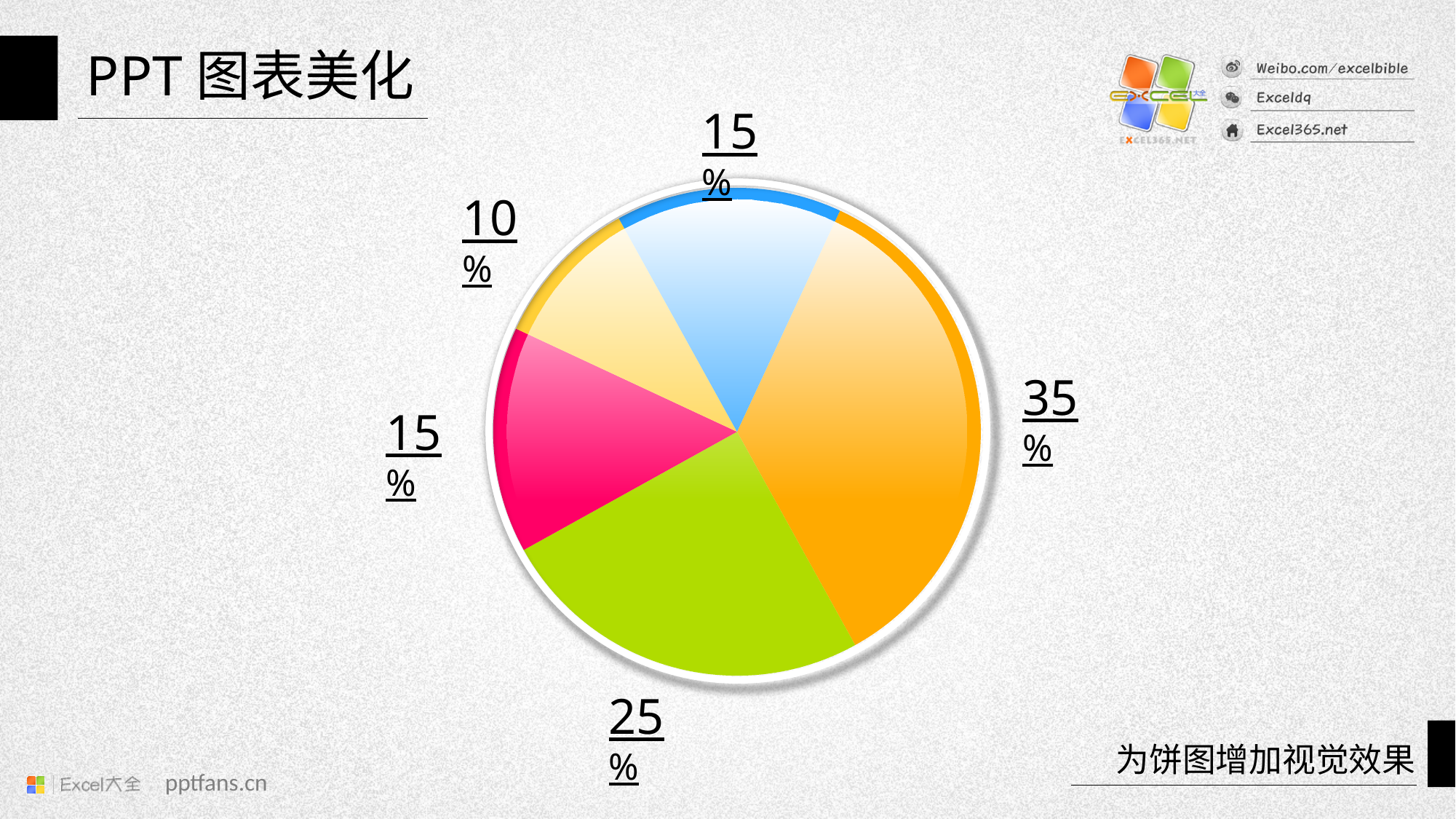
By how many percentage points does the orange slice exceed the green slice? 10 What kind of chart is shown on the slide? pie chart What percentage is shown for the blue slice at the top of the pie chart? 15% Which colour slice is the largest in the pie chart? orange How many slices does the pie chart have? 5 Which is larger, the green slice or the pink slice? green What percentage is shown for the green slice of the pie chart? 25% What percentage is shown for the yellow slice of the pie chart? 10% Which colour slice is the smallest in the pie chart? yellow What percentage is shown for the orange slice of the pie chart? 35% What is the combined share of the pink and yellow slices? 25% Does the pie chart display a legend? No